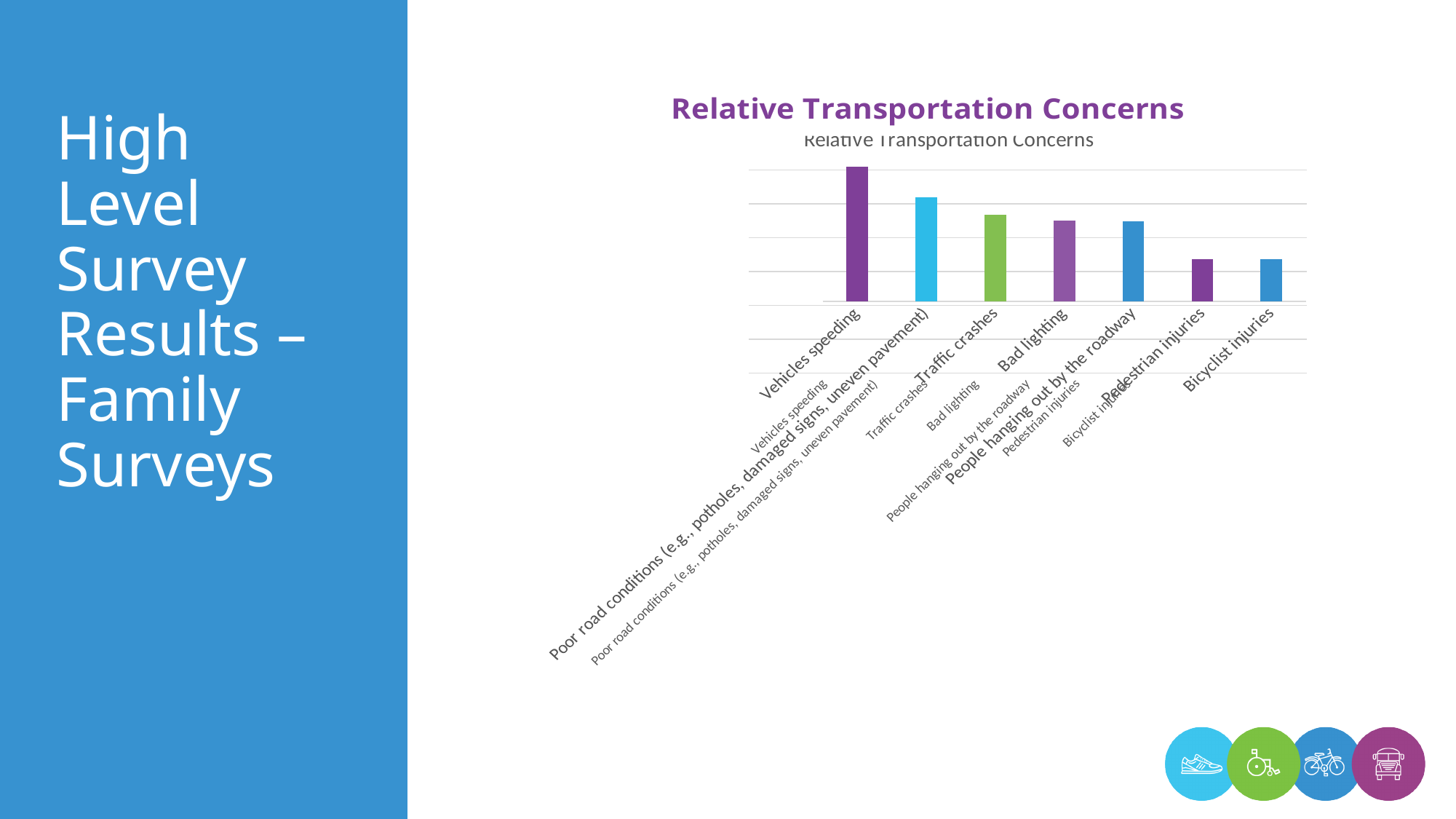
Which is larger, the value for Poor road conditions or the value for Bicyclist injuries? Poor road conditions Which is larger, the value for Traffic crashes or the value for Pedestrian injuries? Traffic crashes What type of chart is shown on the slide? Bar chart How many categories are plotted in the chart? 7 Which is larger, the value for Bad lighting or the value for Bicyclist injuries? Bad lighting Do the bar values generally rise or fall from left to right across the chart? Fall What is the title of the chart? Relative Transportation Concerns What colour is the bar for Traffic crashes? Green Which category has the highest bar in the chart? Vehicles speeding